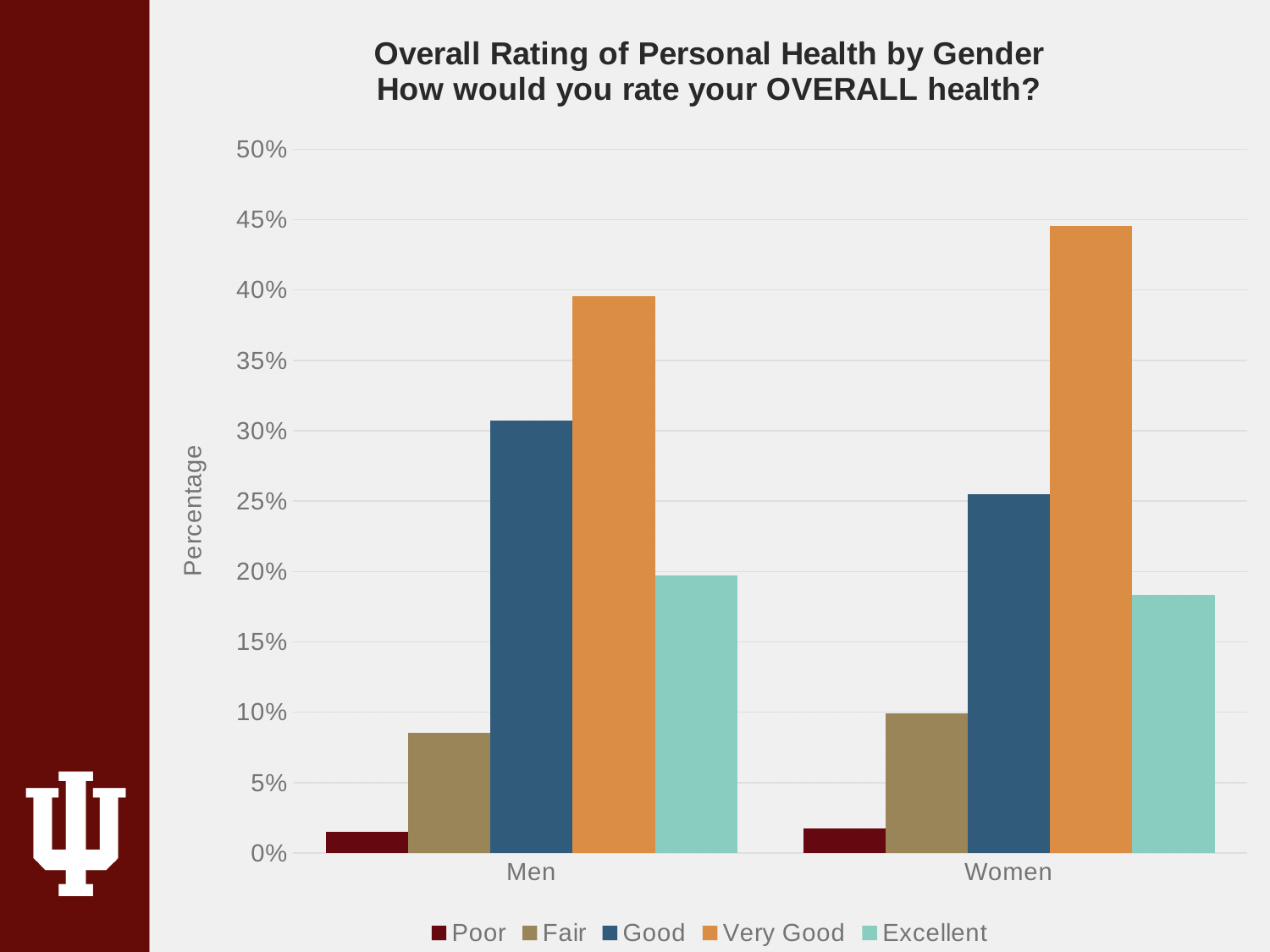
How many gender categories are shown on the x axis? 2 Is the Good value for Women greater or less than 30%? less Which rating has the lowest percentage for Women? Poor Is the Poor value for Men greater or less than 5%? less Is the Very Good value for Men greater or less than 35%? greater Which is larger, the Good value for Men or the Good value for Women? Men Which is larger, the Very Good value for Men or the Very Good value for Women? Women What kind of chart is shown on the slide? bar chart Which rating has the highest percentage for Men? Very Good What is the label on the vertical axis? Percentage How many series does the legend list? 5